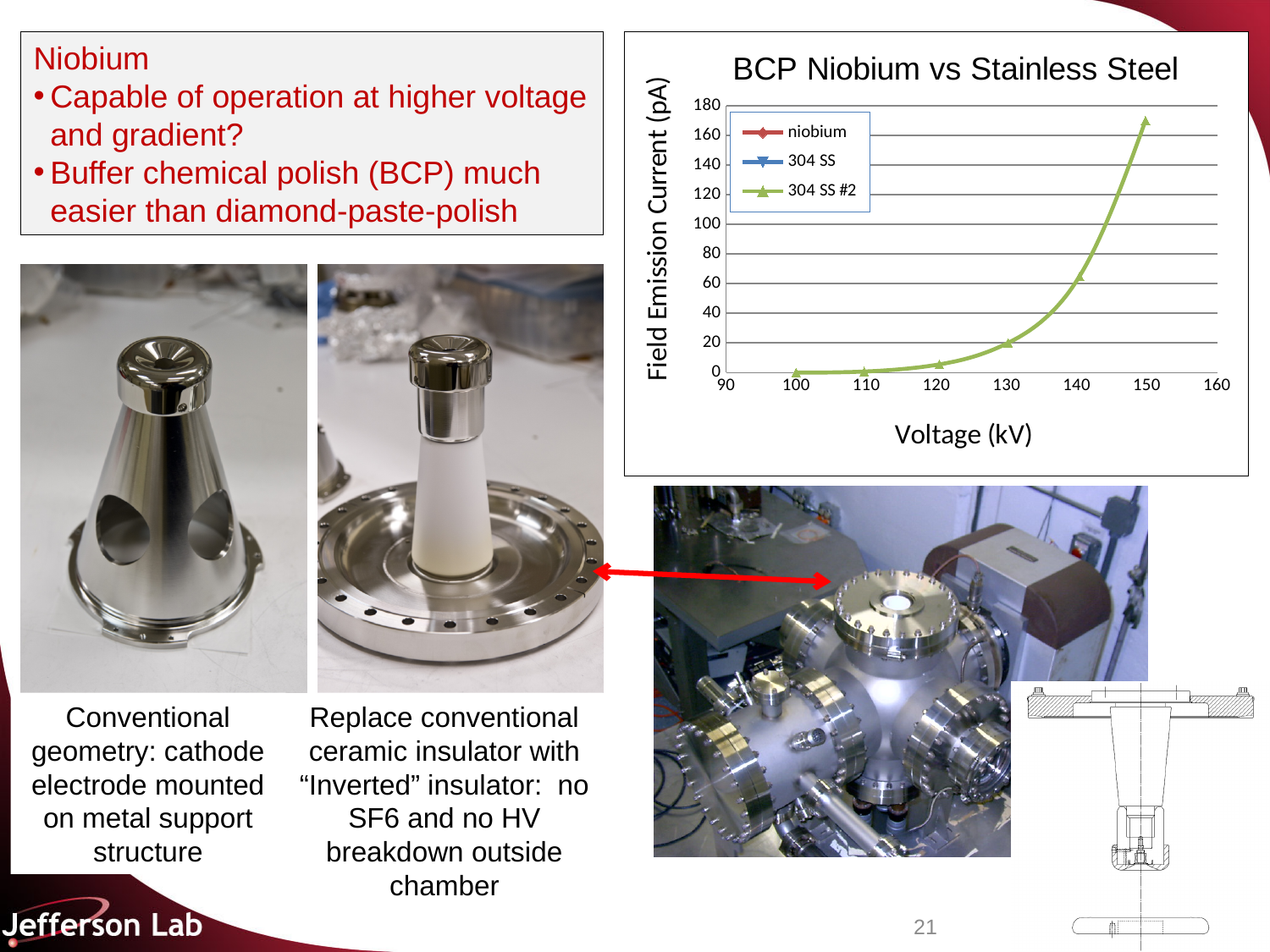
Does the field emission current for 304 SS #2 rise or fall as voltage increases? rise How many series does the chart's legend list? 3 At which voltage does the 304 SS #2 series reach its highest field emission current? 150 kV Is the field emission current for 304 SS #2 at 130 kV greater or less than 40 pA? less What is the label of the y axis of the chart? Field Emission Current (pA) What is the title of the chart? BCP Niobium vs Stainless Steel Is the field emission current for 304 SS #2 at 140 kV greater or less than 40 pA? greater Is the field emission current for 304 SS #2 at 120 kV greater or less than 20 pA? less Which is larger for 304 SS #2: the field emission current at 140 kV or at 150 kV? 150 kV What kind of chart is shown on the slide? line chart How many data points are plotted for the 304 SS #2 series? 6